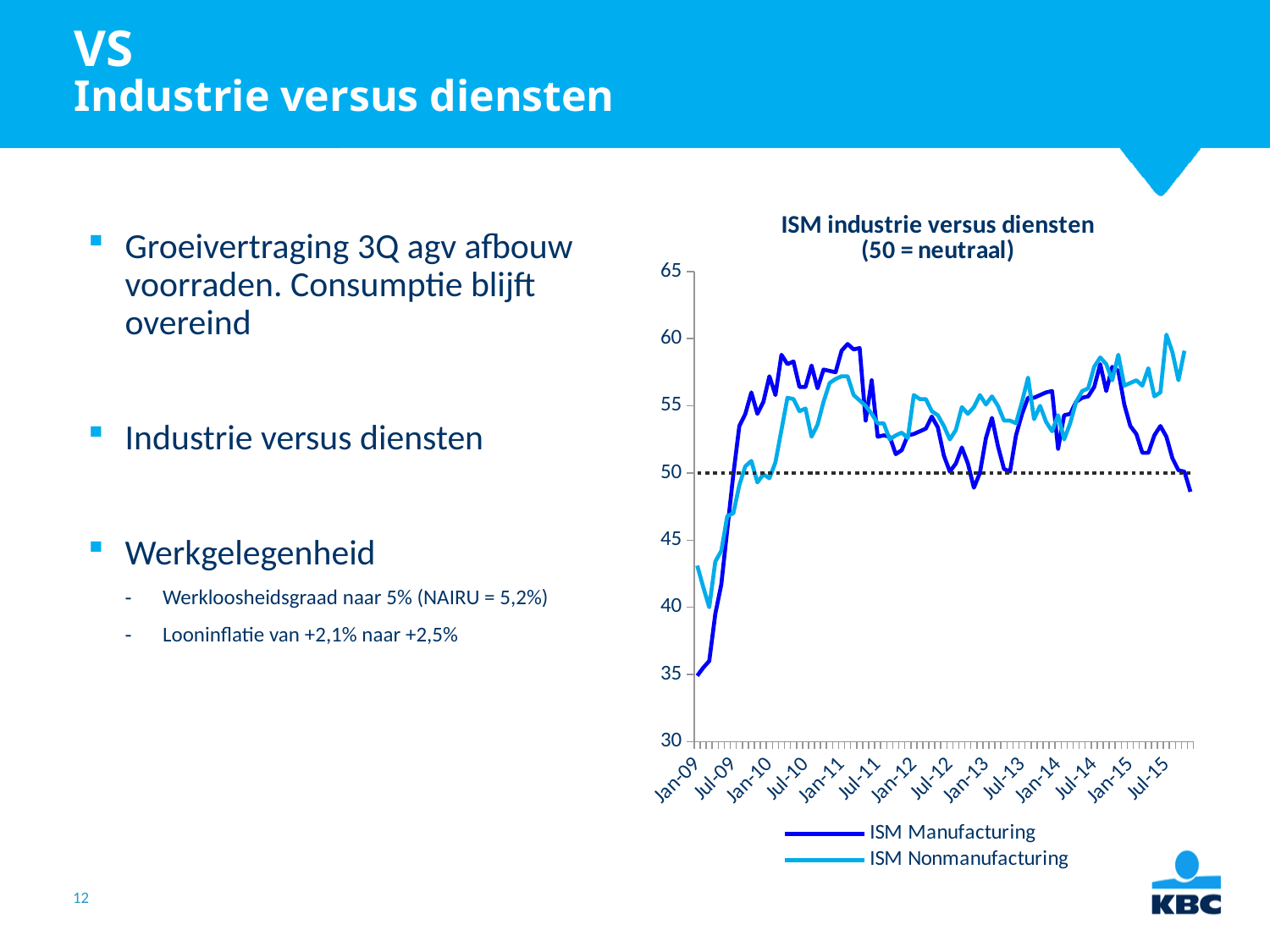
Is the value for ISM Manufacturing at Jan-09 greater or less than 40? less What kind of chart is shown on the slide? line chart Is the value for ISM Nonmanufacturing at Jan-15 greater or less than 55? greater How many series does the legend of the chart list? 2 Does the ISM Manufacturing series rise or fall between Jan-11 and Jan-12? fall Does the ISM Manufacturing series rise or fall between Jan-09 and Jan-10? rise Is the value for ISM Manufacturing at Jan-10 greater or less than 55? greater What is the title of the chart? ISM industrie versus diensten (50 = neutraal) Which two series are listed in the chart legend? ISM Manufacturing and ISM Nonmanufacturing